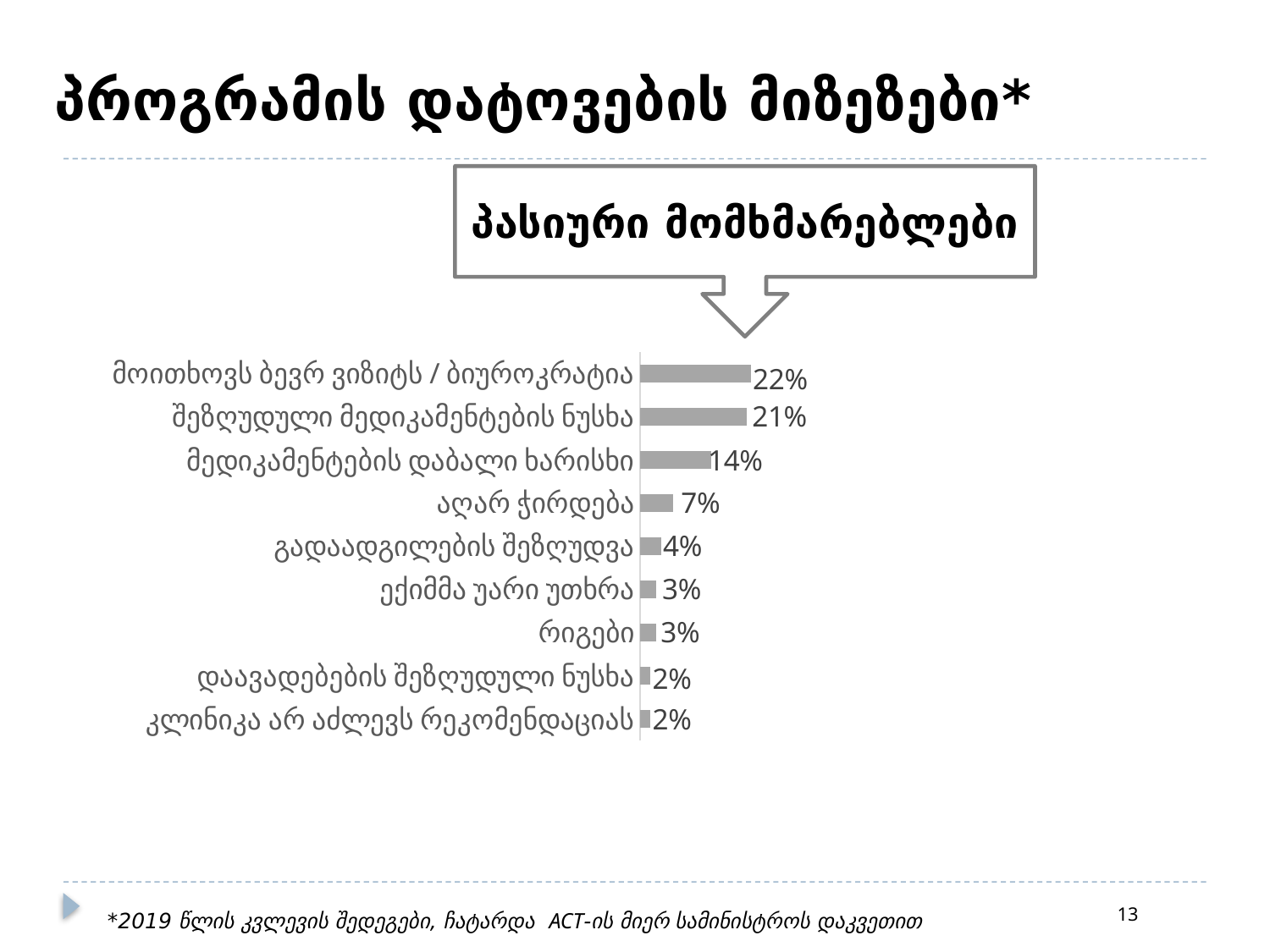
What kind of chart is shown on the slide? bar chart What is the value for "მედიკამენტების დაბალი ხარისხი"? 14% Which category has the highest value in the chart? მოითხოვს ბევრ ვიზიტს / ბიუროკრატია What is the value for "შეზღუდული მედიკამენტების ნუსხა"? 21% What is the value for "მოითხოვს ბევრ ვიზიტს / ბიუროკრატია"? 22% What is the difference between the values for "მოითხოვს ბევრ ვიზიტს / ბიუროკრატია" and "მედიკამენტების დაბალი ხარისხი"? 8% Which is larger, the value for "აღარ ჭირდება" or the value for "რიგები"? აღარ ჭირდება What is the title of the slide containing the chart? პროგრამის დატოვების მიზეზები* What is the difference between the values for "შეზღუდული მედიკამენტების ნუსხა" and "აღარ ჭირდება"? 14% How many categories are plotted in the chart? 9 What is the value for "აღარ ჭირდება"? 7% What is the value for "გადაადგილების შეზღუდვა"? 4%